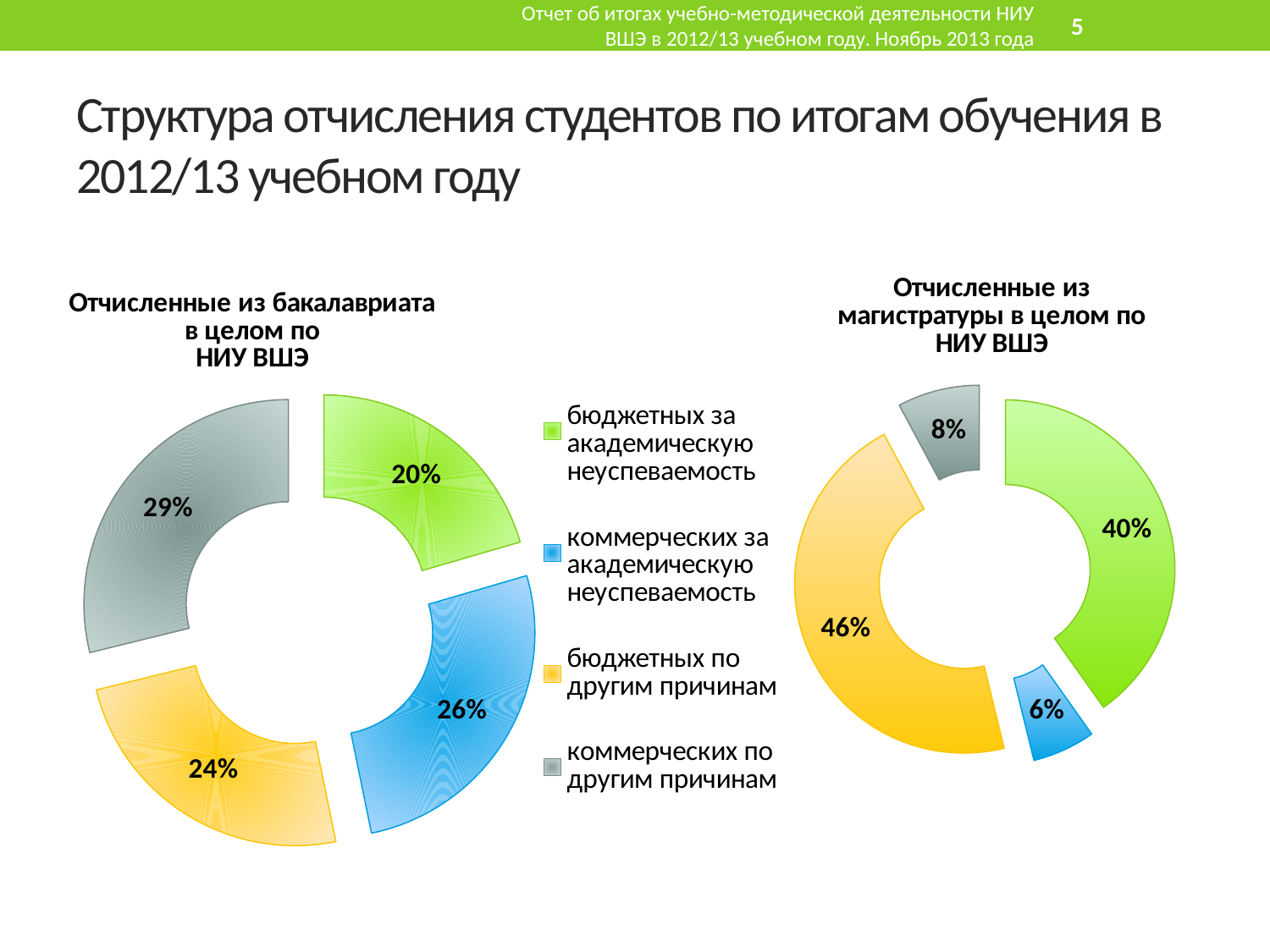
In the chart "Отчисленные из магистратуры в целом по НИУ ВШЭ", what share is "коммерческих за академическую неуспеваемость"? 6% In the chart "Отчисленные из бакалавриата в целом по НИУ ВШЭ", what share is "бюджетных за академическую неуспеваемость"? 20% In the chart "Отчисленные из магистратуры в целом по НИУ ВШЭ", what share is "бюджетных по другим причинам"? 46% In the chart "Отчисленные из бакалавриата в целом по НИУ ВШЭ", what share is "коммерческих по другим причинам"? 29% How many categories does the legend list for the charts on the slide? 4 Which is larger in the chart "Отчисленные из бакалавриата в целом по НИУ ВШЭ": "бюджетных по другим причинам" or "коммерческих за академическую неуспеваемость"? коммерческих за академическую неуспеваемость In the chart "Отчисленные из магистратуры в целом по НИУ ВШЭ", what is the difference in percentage points between "бюджетных по другим причинам" and "бюджетных за академическую неуспеваемость"? 6 In the chart "Отчисленные из магистратуры в целом по НИУ ВШЭ", which category has the smallest share? коммерческих за академическую неуспеваемость What type of chart is used for "Отчисленные из магистратуры в целом по НИУ ВШЭ"? doughnut chart In the chart "Отчисленные из магистратуры в целом по НИУ ВШЭ", which category has the largest share? бюджетных по другим причинам In the chart "Отчисленные из бакалавриата в целом по НИУ ВШЭ", which category has the largest share? коммерческих по другим причинам In the chart "Отчисленные из бакалавриата в целом по НИУ ВШЭ", what is the difference in percentage points between "коммерческих за академическую неуспеваемость" and "бюджетных за академическую неуспеваемость"? 6